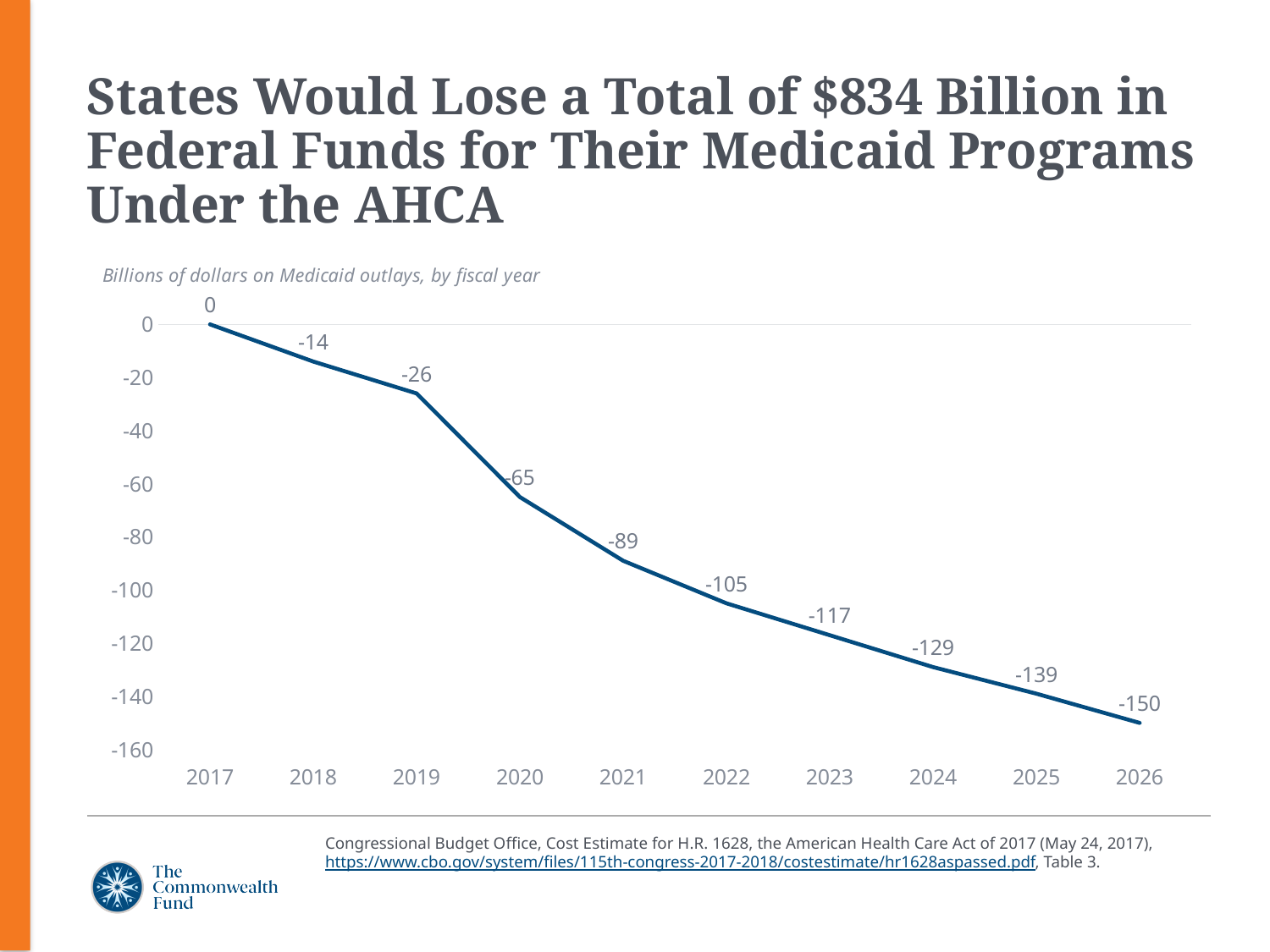
What is the difference between the values for 2021 and 2022? 16 What unit does the chart subtitle say the values are in? Billions of dollars on Medicaid outlays, by fiscal year What is the value for 2020? -65 What kind of chart is shown? Line chart Which is larger, the value for 2019 or the value for 2024? 2019 Do the values rise or fall from 2017 to 2026? Fall How many years are plotted on the chart? 10 Which year has the lowest value? 2026 Which year has the highest value? 2017 What is the value for 2018? -14 What is the value for 2026? -150 What is the value for 2023? -117